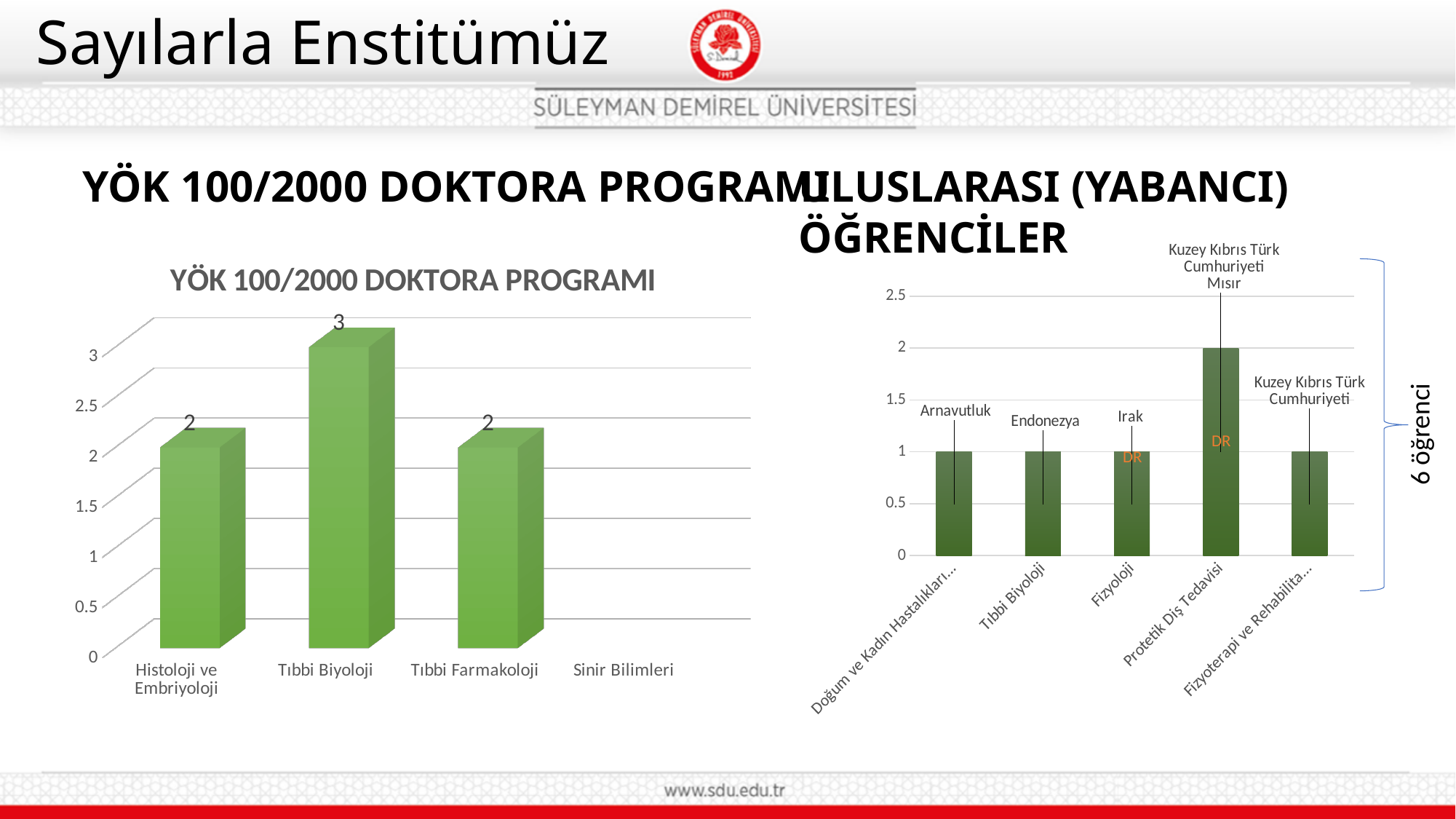
On the YÖK 100/2000 DOKTORA PROGRAMI chart, which category has the highest value? Tıbbi Biyoloji What kind of chart is the YÖK 100/2000 DOKTORA PROGRAMI chart? bar chart On the ULUSLARASI (YABANCI) ÖĞRENCİLER chart, which is larger: Protetik Diş Tedavisi or Tıbbi Biyoloji? Protetik Diş Tedavisi On the ULUSLARASI (YABANCI) ÖĞRENCİLER chart, which category has the highest value? Protetik Diş Tedavisi On the YÖK 100/2000 DOKTORA PROGRAMI chart, what is the value for Histoloji ve Embriyoloji? 2 On the ULUSLARASI (YABANCI) ÖĞRENCİLER chart, what is the value for Fizyoloji? 1 On the YÖK 100/2000 DOKTORA PROGRAMI chart, what is the value for Tıbbi Biyoloji? 3 On the YÖK 100/2000 DOKTORA PROGRAMI chart, how many categories are shown on the x axis? 4 On the YÖK 100/2000 DOKTORA PROGRAMI chart, what is the difference between Tıbbi Biyoloji and Tıbbi Farmakoloji? 1 On the ULUSLARASI (YABANCI) ÖĞRENCİLER chart, how many bars are shown? 5 On the ULUSLARASI (YABANCI) ÖĞRENCİLER chart, which country is labelled above the Fizyoloji bar? Irak On the ULUSLARASI (YABANCI) ÖĞRENCİLER chart, what is the value for Protetik Diş Tedavisi? 2